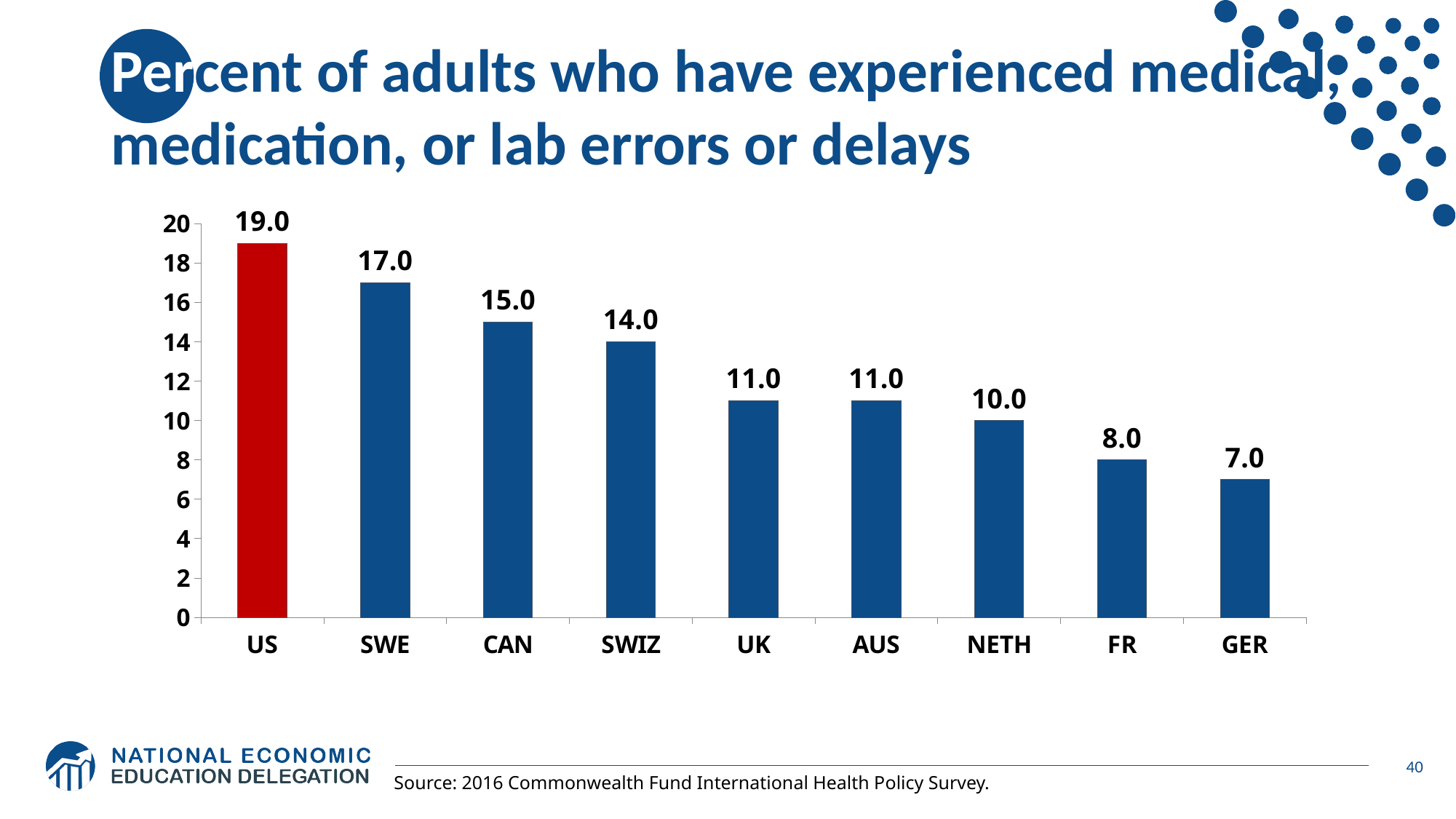
What is the value for SWIZ? 14.0 Which country has the highest value? US Which country has the lowest value? GER Do the values rise or fall from left to right across the chart? fall How many countries are shown on the chart? 9 What kind of chart is shown on the slide? bar chart What is the value for the US? 19.0 What is the value for NETH? 10.0 Which is larger, the value for CAN or the value for FR? CAN Which bar is coloured red rather than blue? US What is the difference between the values for the US and GER? 12.0 What is the difference between the values for SWE and CAN? 2.0